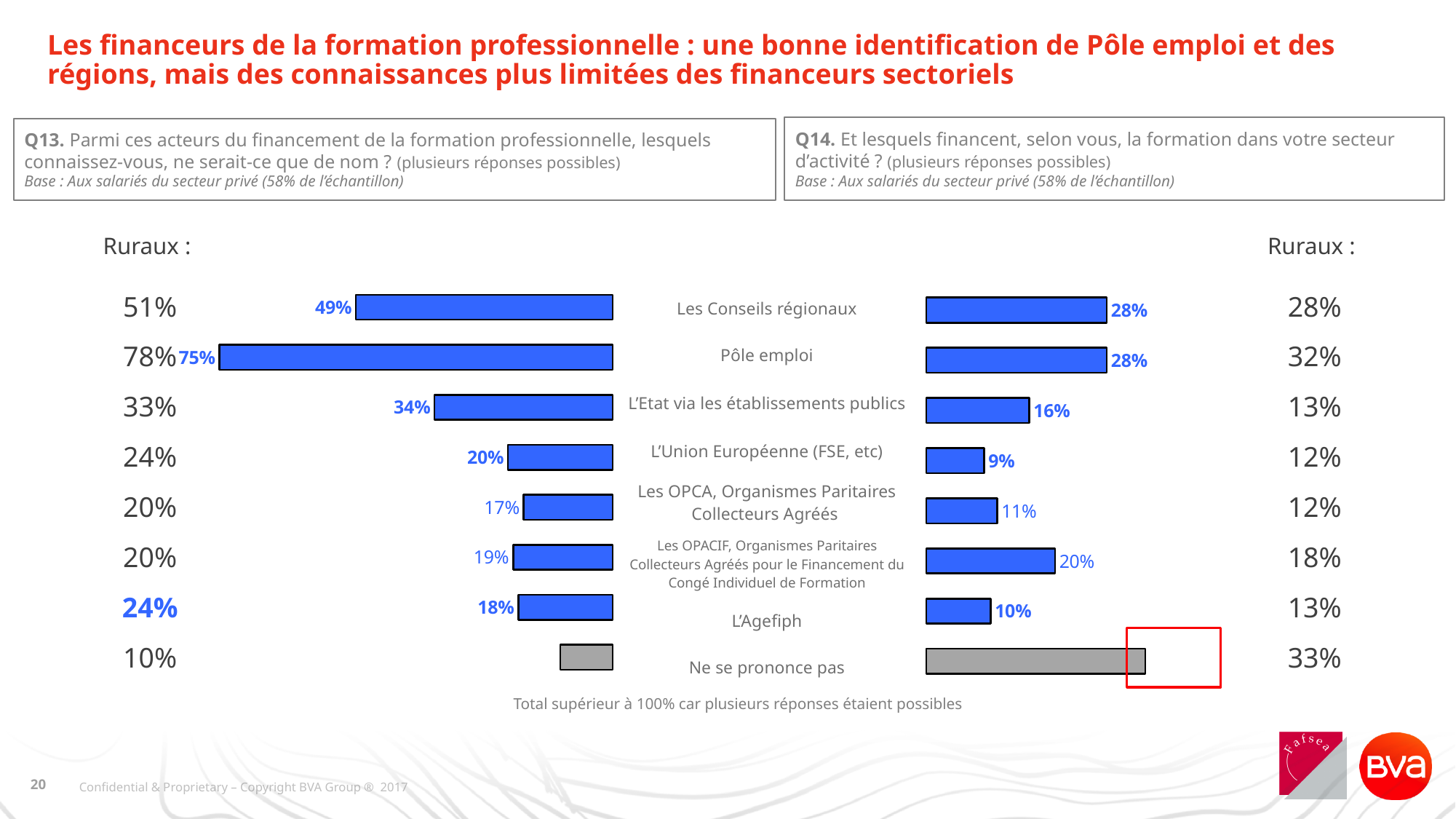
In the left chart (Q13), what is the value for Pôle emploi? 75% In the right chart (Q14), which labelled category has the lowest value? L'Union Européenne (FSE, etc) In the left chart (Q13), which category has the highest value? Pôle emploi How many categories are shown in the left chart (Q13)? 8 In the left chart (Q13), which is larger: the value for L'Etat via les établissements publics or the value for L'Union Européenne (FSE, etc)? L'Etat via les établissements publics What kind of chart is the right chart (Q14)? Bar chart In the right chart (Q14), what is the value for L'Union Européenne (FSE, etc)? 9% In the right chart (Q14), what is the difference between the values for Les OPACIF and L'Agefiph? 10% In the right chart (Q14), which is larger: the value for Les OPACIF or the value for Les OPCA? Les OPACIF In the right chart (Q14), what is the value for L'Etat via les établissements publics? 16% In the left chart (Q13), what is the difference between the values for Pôle emploi and Les Conseils régionaux? 26% In the left chart (Q13), what is the value for L'Agefiph? 18%